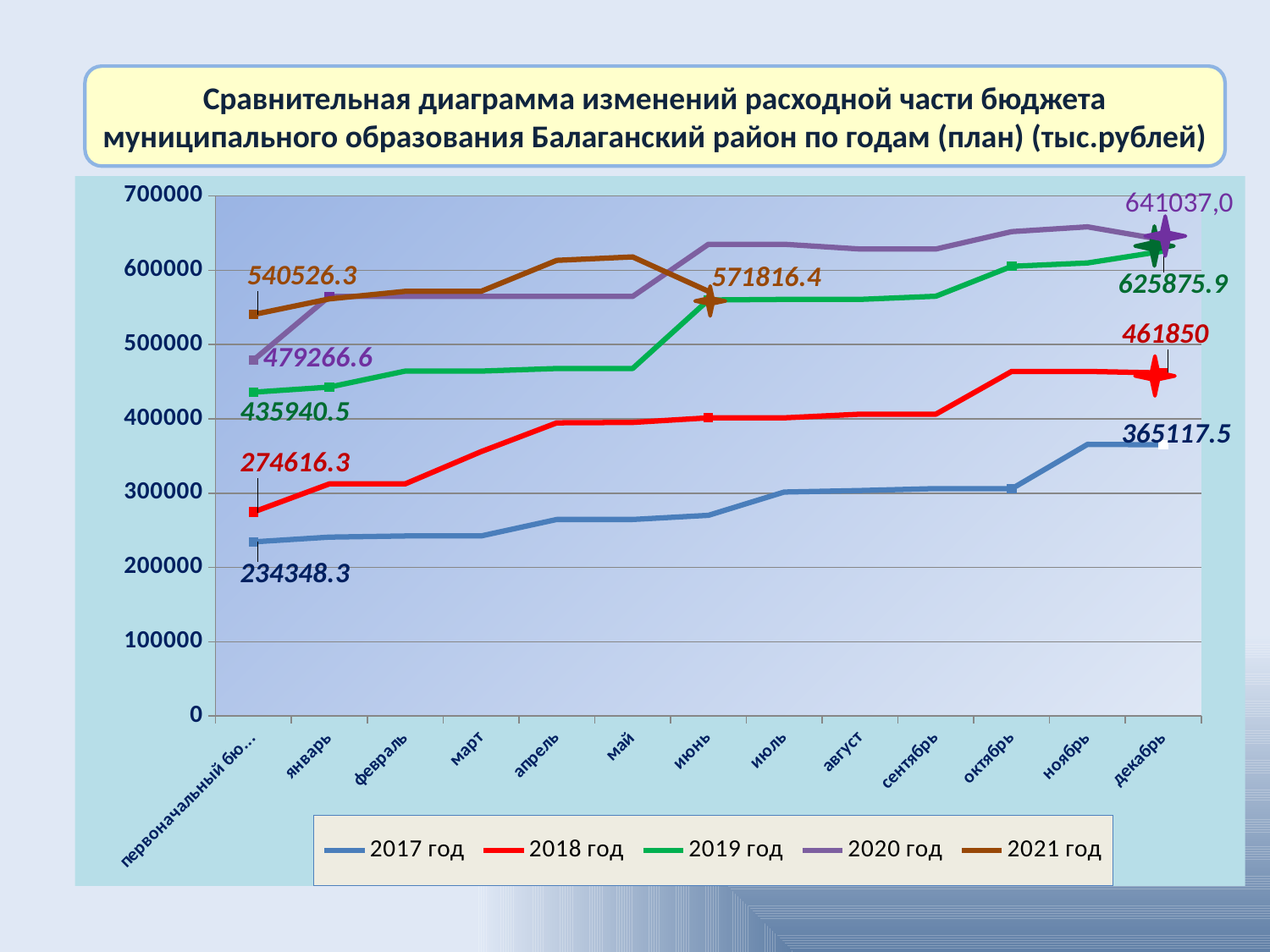
By how much does the 2017 год value in декабрь exceed its first (первоначальный бюджет) value? 130769.2 What is the first (первоначальный бюджет) value for 2019 год? 435940.5 What is the value for 2021 год in июнь? 571816.4 How many series does the legend list? 5 What is the value for 2020 год in декабрь? 641037,0 Which series has the highest value in декабрь? 2020 год How many categories are shown along the x axis? 13 Is the value for 2019 год in март greater or less than 500000? less What is the value for 2018 год in декабрь? 461850 Which is larger in декабрь: the value for 2019 год or for 2020 год? 2020 год What is the value for 2017 год in декабрь? 365117.5 What kind of chart is shown on the slide? line chart